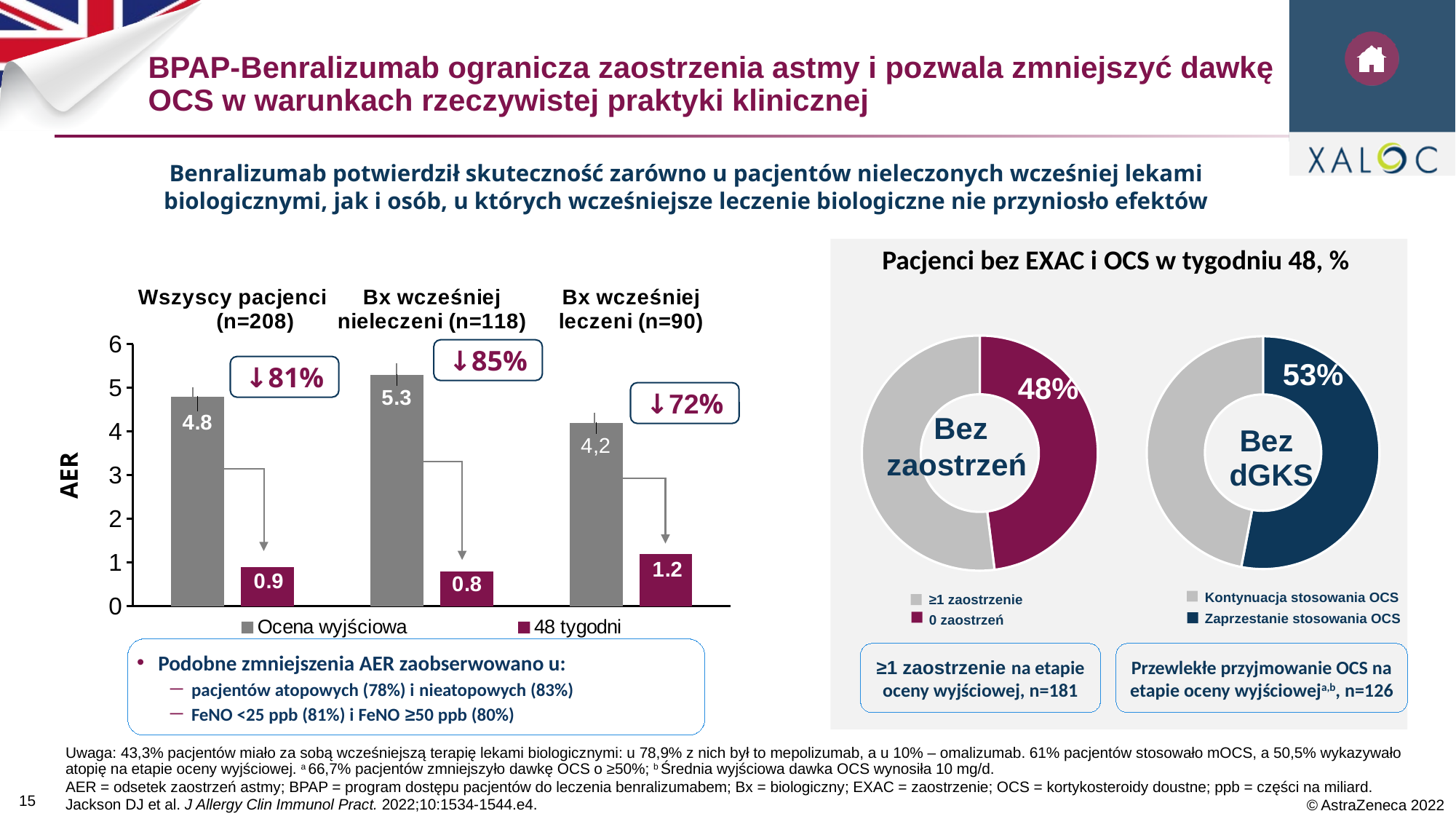
In the AER bar chart, how many series does the legend list? 2 In the AER bar chart, what is the 48 tygodni value for Bx wcześniej leczeni (n=90)? 1.2 In the AER bar chart, which is larger: the 48 tygodni value for Bx wcześniej leczeni (n=90) or for Wszyscy pacjenci (n=208)? Bx wcześniej leczeni (n=90) In the AER bar chart, which patient group has the lowest 48 tygodni AER? Bx wcześniej nieleczeni (n=118) In the AER bar chart, which patient group has the highest baseline (Ocena wyjściowa) AER? Bx wcześniej nieleczeni (n=118) In the left donut chart under 'Pacjenci bez EXAC i OCS w tygodniu 48, %', what share of patients had 0 zaostrzeń? 48% What type of chart is used to show AER on the left of the slide? Bar chart In the AER bar chart, what percentage reduction is shown for Bx wcześniej nieleczeni (n=118)? 85% In the right donut chart under 'Pacjenci bez EXAC i OCS w tygodniu 48, %', what share of patients had Zaprzestanie stosowania OCS? 53% In the AER bar chart, what is the baseline (Ocena wyjściowa) value for Wszyscy pacjenci (n=208)? 4.8 In the AER bar chart, what is the difference between the baseline and 48 tygodni values for Wszyscy pacjenci (n=208)? 3.9 In the AER bar chart, what is the 48 tygodni value for Bx wcześniej nieleczeni (n=118)? 0.8